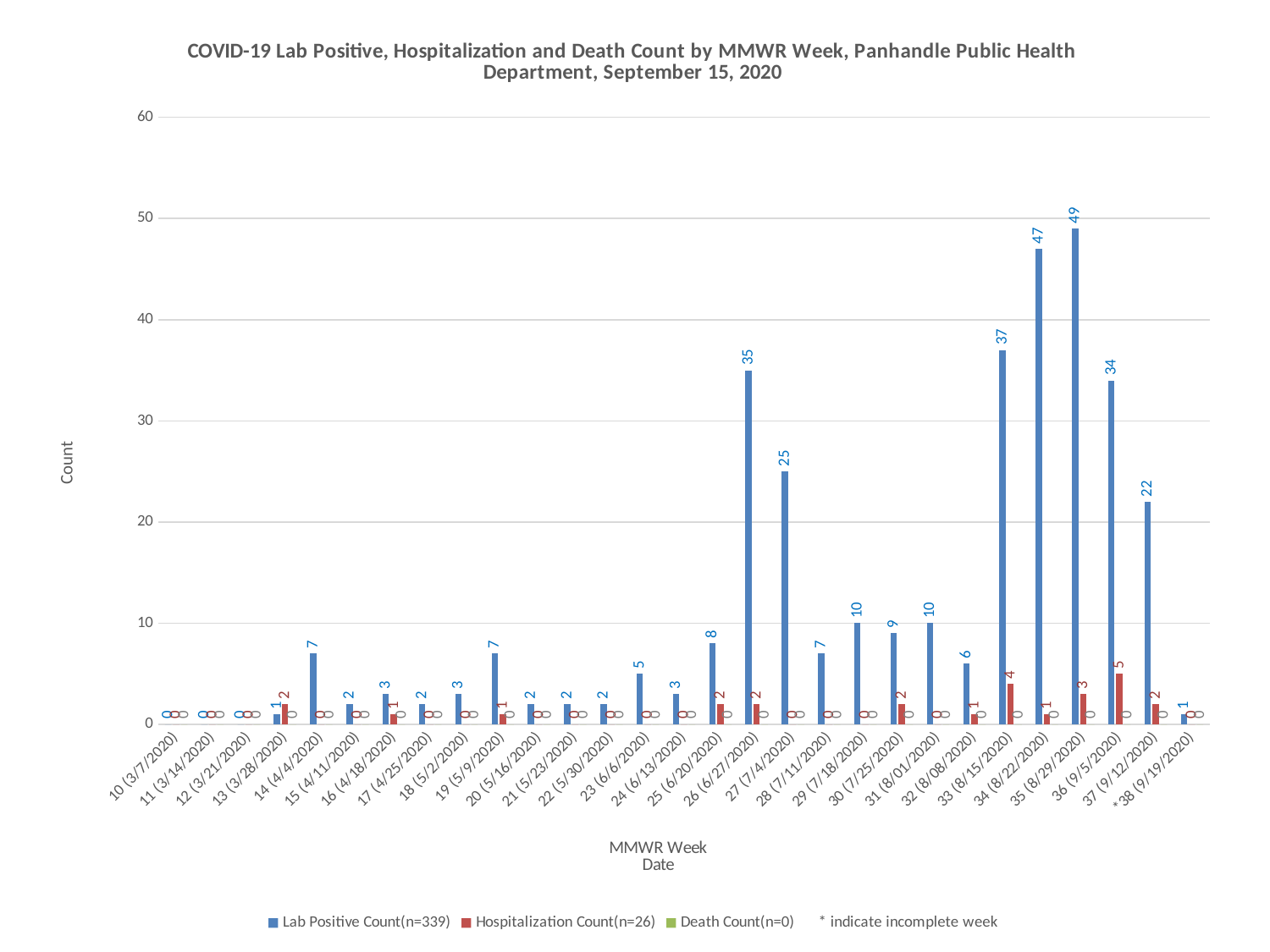
What is the Lab Positive Count for MMWR week 37 (9/12/2020)? 22 What is the Lab Positive Count for MMWR week 27 (7/4/2020)? 25 What is the Hospitalization Count for MMWR week 36 (9/5/2020)? 5 How many series does the legend list? 3 What is the Lab Positive Count for MMWR week 35 (8/29/2020)? 49 What is the Hospitalization Count for MMWR week 33 (8/15/2020)? 4 Which MMWR week has the highest Hospitalization Count? 36 (9/5/2020) What is the difference between the Lab Positive Count for week 34 (8/22/2020) and week 33 (8/15/2020)? 10 Which has a larger Lab Positive Count, week 26 (6/27/2020) or week 27 (7/4/2020)? 26 (6/27/2020) Which MMWR week has the highest Lab Positive Count? 35 (8/29/2020) What kind of chart is shown on the slide? Bar chart Which MMWR week is marked with an asterisk as an incomplete week? 38 (9/19/2020)